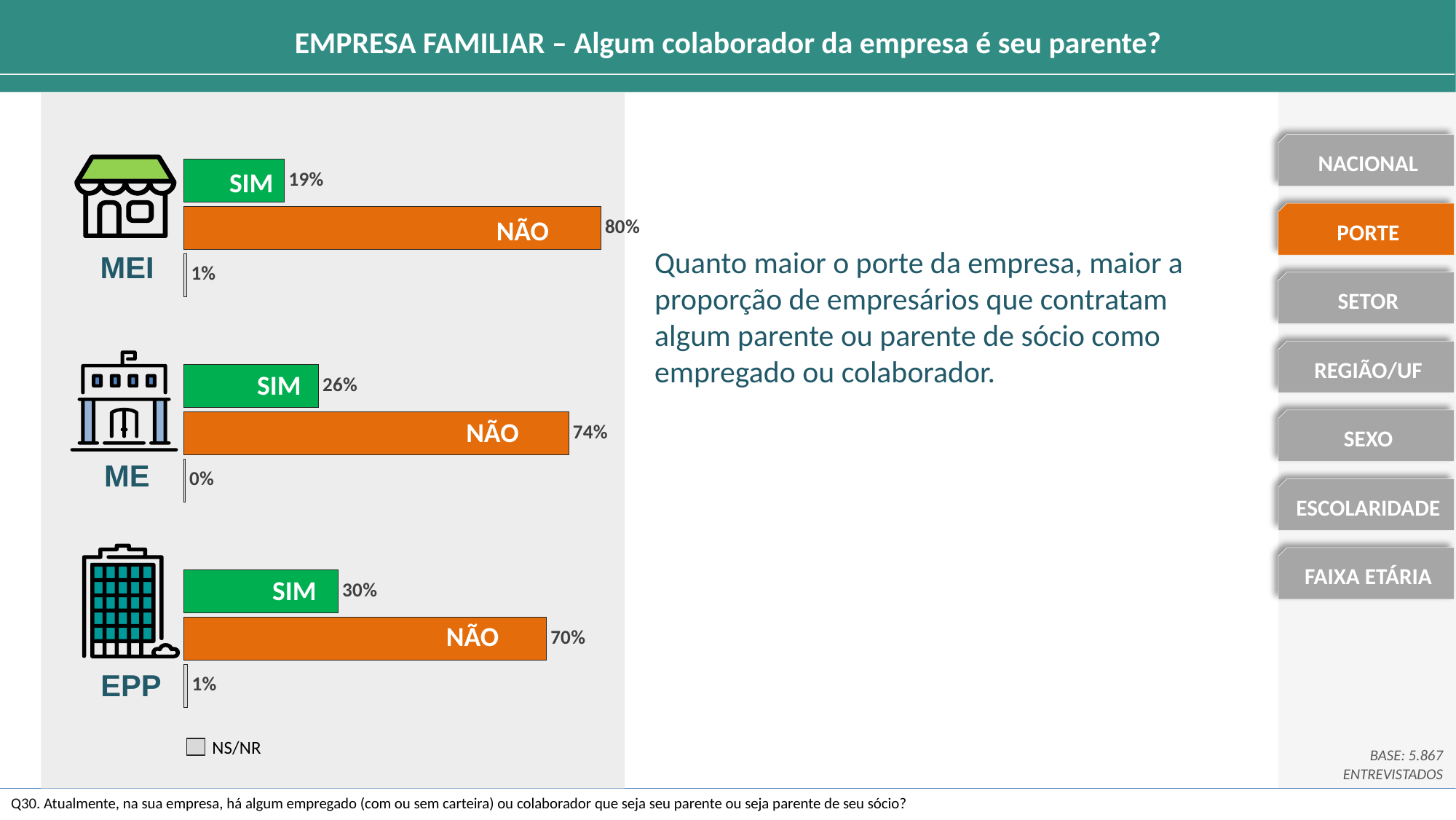
Which is larger: the SIM percentage for ME or the SIM percentage for MEI? ME What colour are the NÃO bars in the charts? Orange How many response categories are shown for each company size (MEI, ME, EPP)? 3 Across the MEI, ME and EPP charts, which company size has the lowest NÃO percentage? EPP Across the MEI, ME and EPP charts, which company size has the highest SIM percentage? EPP What type of chart is used to show the SIM and NÃO responses? Bar chart In the MEI chart, what percentage answered NÃO? 80% In the EPP chart, what percentage answered NÃO? 70% In the ME chart, what is the value for NS/NR? 0% In the EPP chart, what is the difference between the NÃO and SIM percentages? 40% In the ME chart, what percentage answered SIM? 26% In the MEI chart, what percentage answered SIM? 19%